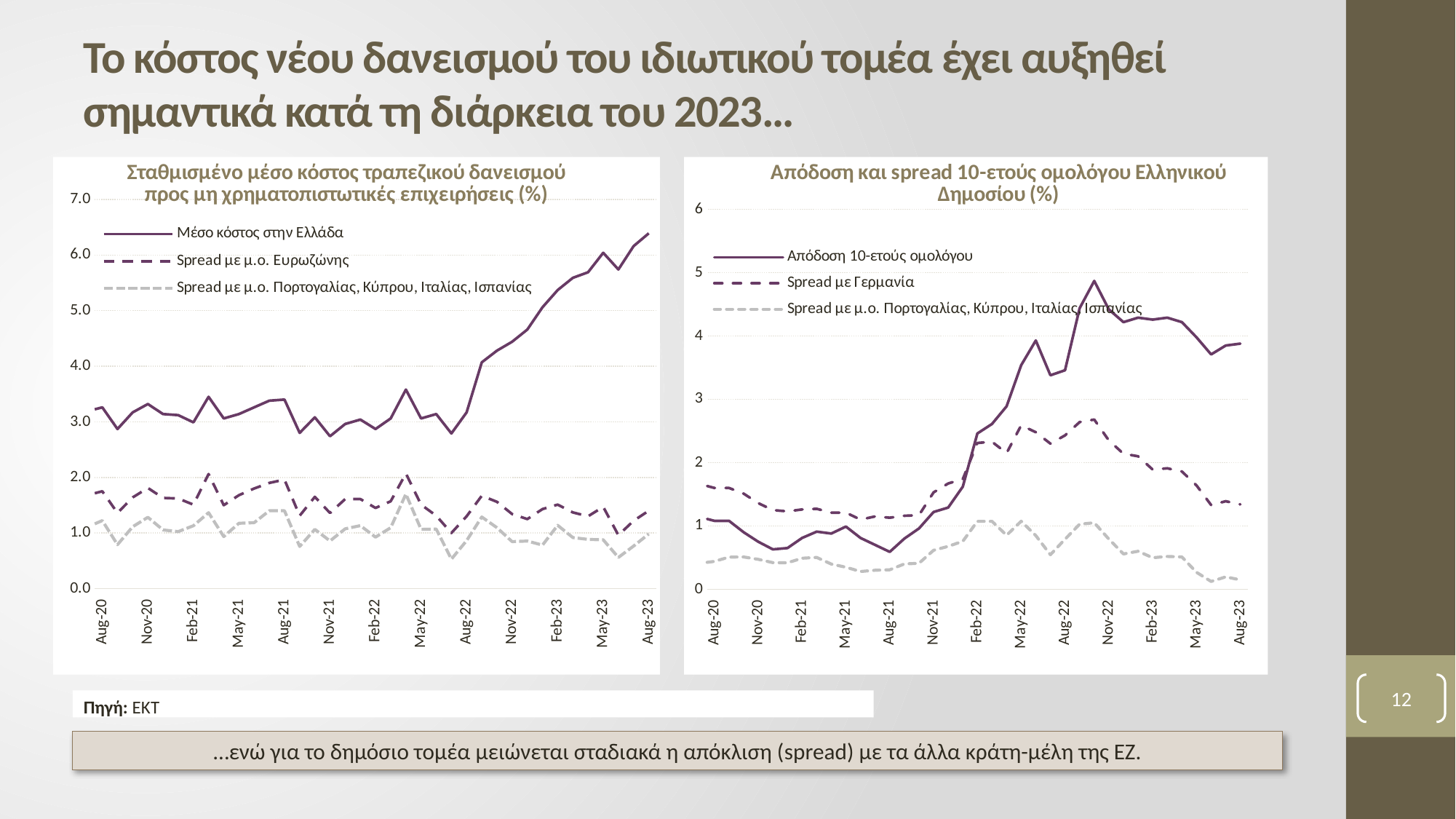
In the left chart, is the value of 'Μέσο κόστος στην Ελλάδα' in Aug-23 greater or less than 6.0? greater In the left chart, does 'Μέσο κόστος στην Ελλάδα' rise or fall overall from Aug-20 to Aug-23? Rise In the left chart, is the value of 'Μέσο κόστος στην Ελλάδα' in Aug-20 greater or less than 4.0? less What kind of chart is the left chart, 'Σταθμισμένο μέσο κόστος τραπεζικού δανεισμού προς μη χρηματοπιστωτικές επιχειρήσεις (%)'? Line chart What kind of chart is the right chart, 'Απόδοση και spread 10-ετούς ομολόγου Ελληνικού Δημοσίου (%)'? Line chart What source is cited for the charts on the slide? ΕΚΤ How many series does the legend of the left chart list? 3 How many series does the legend of the right chart list? 3 In the right chart, which series has the highest value in Aug-23? Απόδοση 10-ετούς ομολόγου In the right chart, is the value of 'Spread με Γερμανία' in Aug-23 greater or less than 2? less